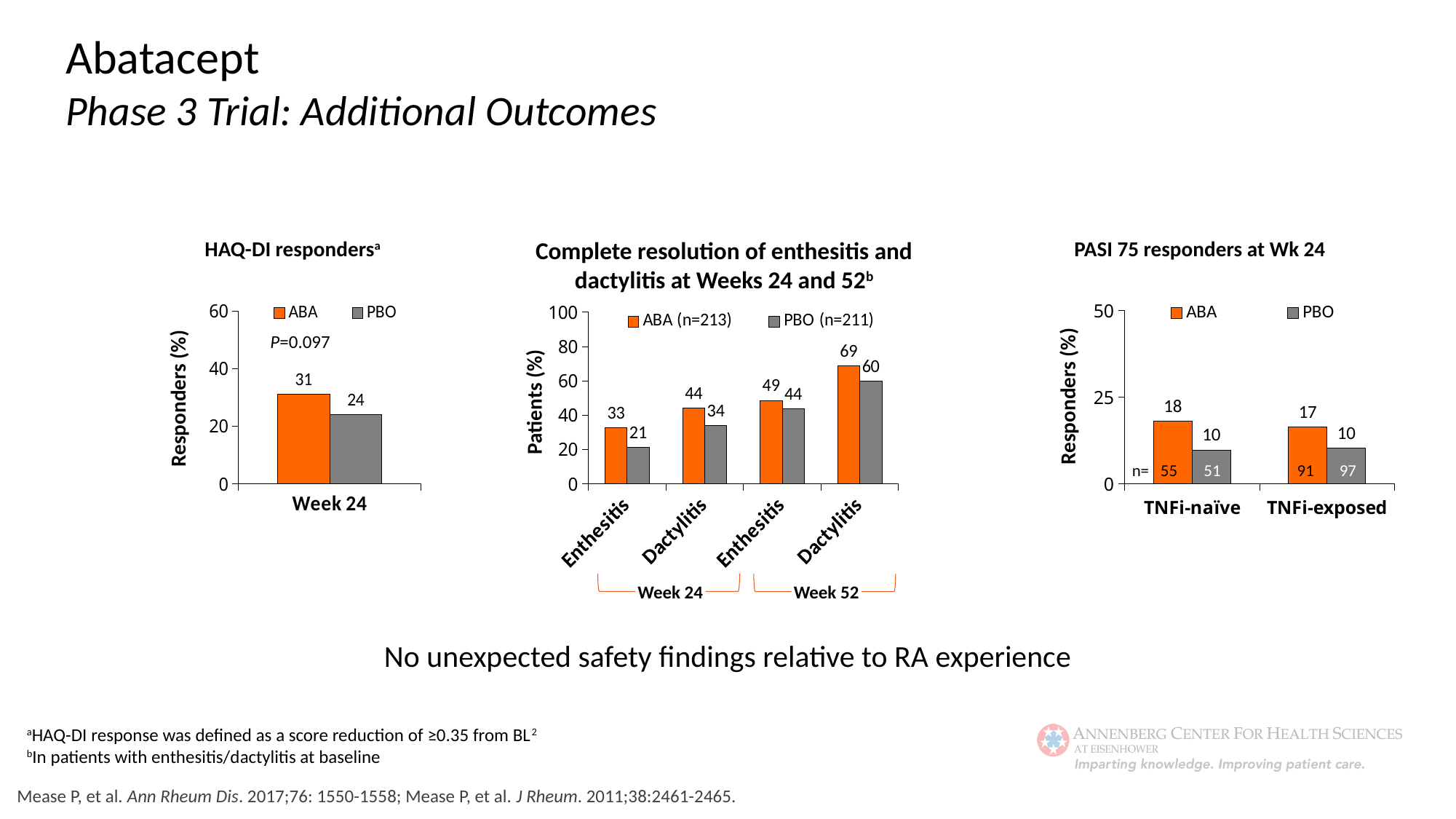
In the 'Complete resolution of enthesitis and dactylitis' chart, what is the difference between ABA and PBO for Enthesitis at Week 24? 12 In the 'PASI 75 responders at Wk 24' chart, which is larger, the ABA value for TNFi-naïve or the PBO value for TNFi-naïve? ABA In the 'Complete resolution of enthesitis and dactylitis' chart, what is the PBO value for Enthesitis at Week 24? 21 In the 'Complete resolution of enthesitis and dactylitis' chart, what is the ABA value for Dactylitis at Week 52? 69 In the 'PASI 75 responders at Wk 24' chart, is the ABA value for TNFi-exposed greater or less than 25? less In the HAQ-DI responders chart, what is the value for PBO at Week 24? 24 In the 'Complete resolution of enthesitis and dactylitis' chart, which category has the lowest PBO value? Enthesitis at Week 24 In the HAQ-DI responders chart, what is the difference between the ABA and PBO values at Week 24? 7 In the 'Complete resolution of enthesitis and dactylitis' chart, how many series does the legend list? 2 What kind of chart is the 'PASI 75 responders at Wk 24' chart? Bar chart In the 'PASI 75 responders at Wk 24' chart, what is the ABA value for TNFi-naïve patients? 18 In the HAQ-DI responders chart, what is the value for ABA at Week 24? 31